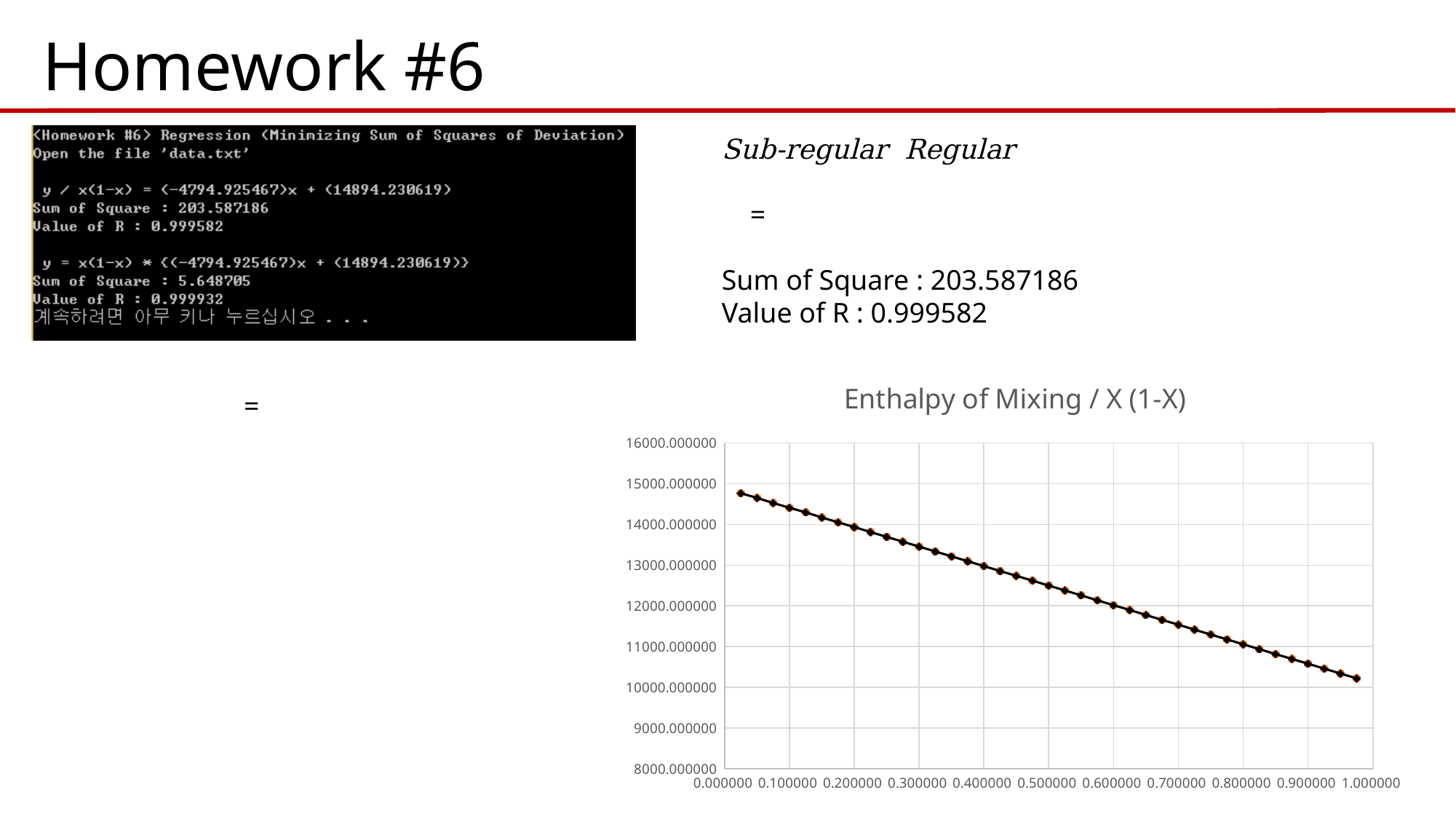
What kind of chart is shown on the slide? scatter chart with a fitted line At which end of the x axis is the lowest plotted value found, near 0.000000 or near 1.000000? near 1.000000 Is the plotted value at x = 0.300000 greater or less than 13000.000000? greater Is the plotted value at x = 0.900000 greater or less than 11000.000000? less What is the maximum value shown on the chart's y axis? 16000.000000 Do the plotted values rise or fall as x increases from 0 to 1? fall What is the title of the chart? Enthalpy of Mixing / X (1-X) Is the plotted value at x = 0.100000 greater or less than 14000.000000? greater Which has the larger plotted value, x = 0.200000 or x = 0.800000? x = 0.200000 At which end of the x axis is the highest plotted value found, near 0.000000 or near 1.000000? near 0.000000